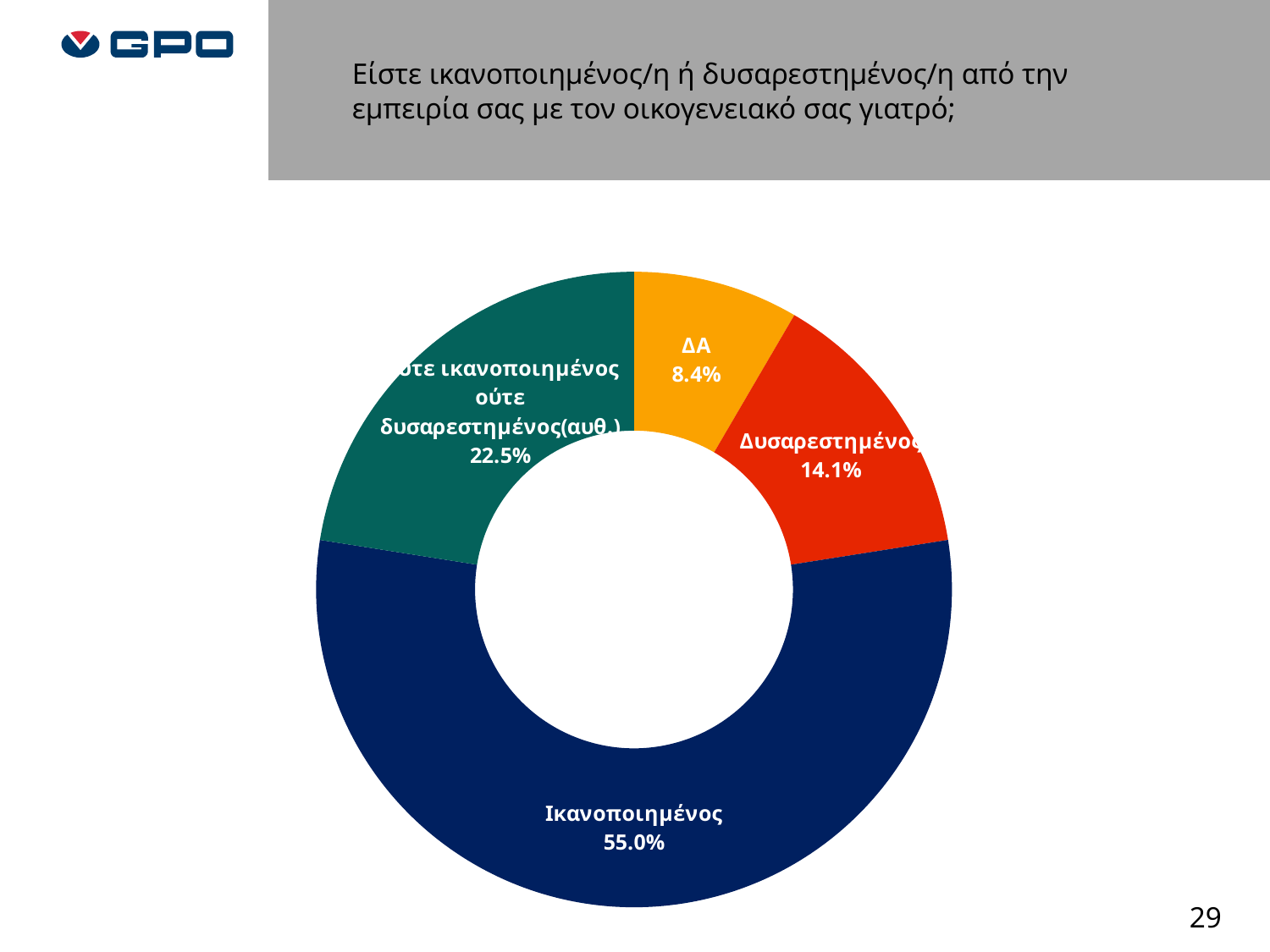
What is the difference in percentage points between the 'ούτε ικανοποιημένος ούτε δυσαρεστημένος(αυθ.)' slice and ΔΑ? 14.1 What percentage of respondents answered Δυσαρεστημένος? 14.1% What percentage of respondents answered Ικανοποιημένος? 55.0% Which category has the smallest share of the chart? ΔΑ What colour is the Ικανοποιημένος slice? Dark blue What type of chart is shown on the slide? Doughnut chart What percentage is shown for ΔΑ? 8.4% What is the difference in percentage points between Ικανοποιημένος and Δυσαρεστημένος? 40.9 What percentage is shown for the 'ούτε ικανοποιημένος ούτε δυσαρεστημένος(αυθ.)' slice? 22.5% How many slices does the chart have? 4 Which category has the largest share of the chart? Ικανοποιημένος Which is larger, the share for Δυσαρεστημένος or the share for ΔΑ? Δυσαρεστημένος